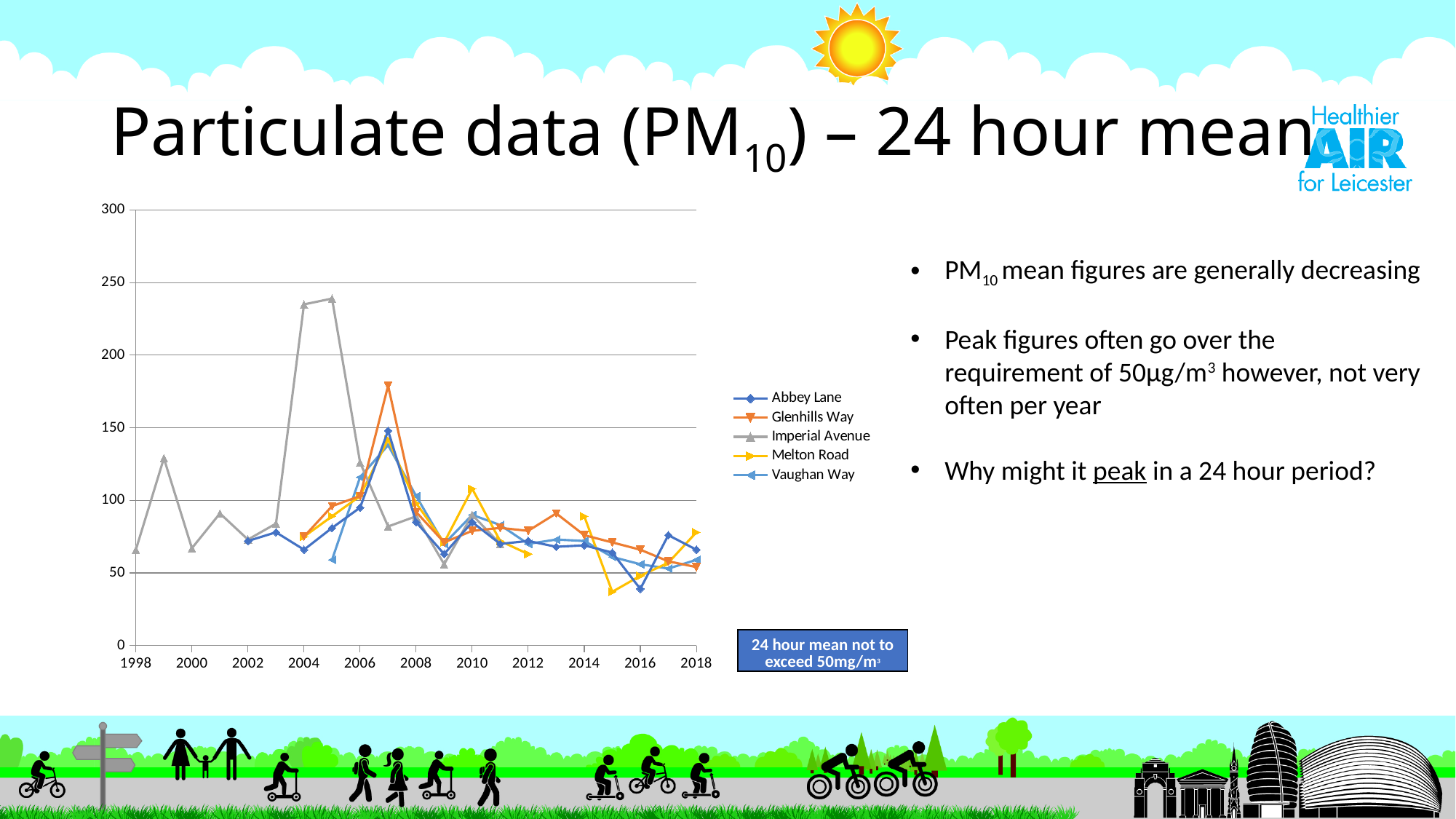
Which series has the highest value in 2007? Glenhills Way How many year labels are shown on the x axis? 11 Does the Imperial Avenue line rise or fall between 2005 and 2009? fall Is the value for Imperial Avenue in 2005 greater or less than 200? greater Is the value for Imperial Avenue in 1998 greater or less than 100? less What is the highest value shown on the y axis? 300 Which is larger: the Imperial Avenue value in 2005 or the Glenhills Way value in 2007? Imperial Avenue in 2005 Is the value for Glenhills Way in 2007 greater or less than 150? greater How many series does the chart legend list? 5 What kind of chart is shown on the slide? line chart Which series reaches the highest value anywhere on the chart? Imperial Avenue